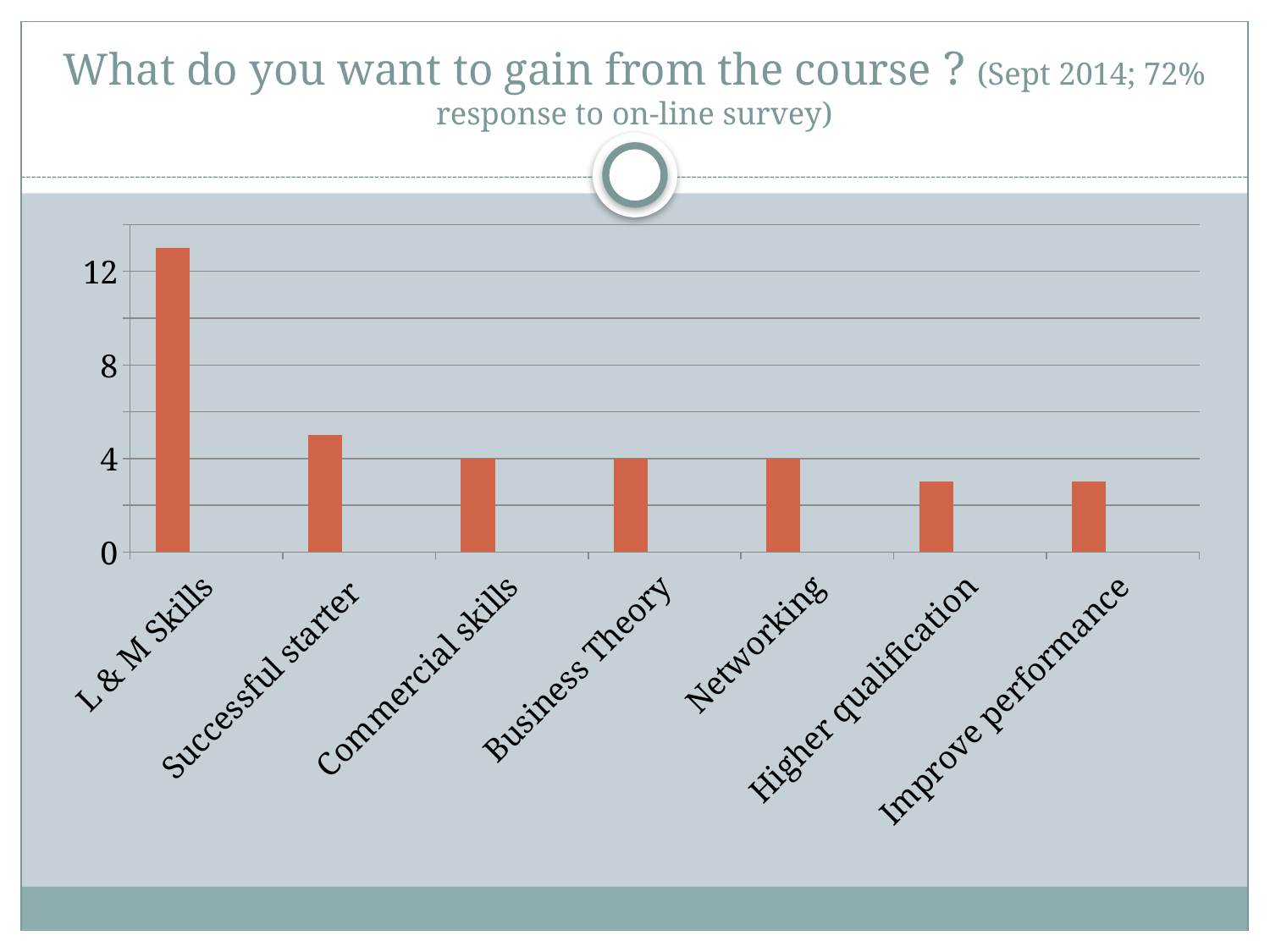
Is the value for Successful starter greater or less than 4? greater What kind of chart is shown on the slide? Bar chart Which is larger, the value for L & M Skills or the value for Successful starter? L & M Skills What is the title of the chart on the slide? What do you want to gain from the course ? (Sept 2014; 72% response to on-line survey) What is the value for Commercial skills? 4 Do the values generally rise or fall moving from left to right along the x axis? fall Is the value for L & M Skills greater or less than 12? greater Is the value for Higher qualification greater or less than 4? less How many categories are shown on the x axis of the chart? 7 Which category has the highest value in the chart? L & M Skills What is the value for Networking? 4